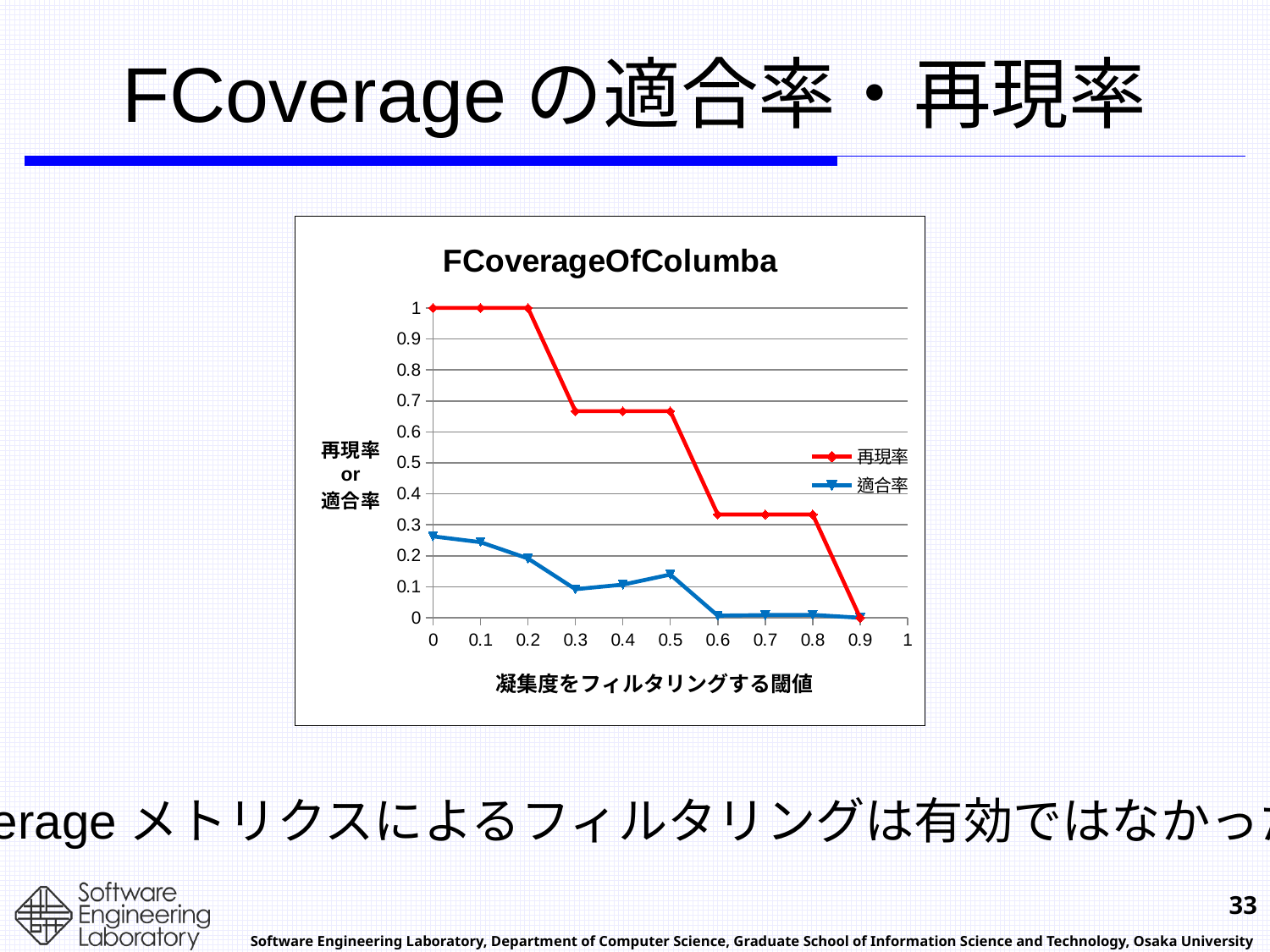
What is the value of 再現率 at threshold 0.9? 0 What kind of chart is shown on the slide? line chart Is the value of 再現率 at threshold 0.6 greater or less than 0.5? less At threshold 0.4, which series has the higher value, 再現率 or 適合率? 再現率 How many series does the legend list? 2 Is the value of 再現率 at threshold 0.3 greater or less than 0.5? greater Is the value of 適合率 at threshold 0.3 greater or less than 0.2? less Does the 再現率 series rise or fall as the threshold increases along the x axis? fall What is the label of the x axis? 凝集度をフィルタリングする閾値 What is the value of 再現率 at threshold 0? 1 How many data points does the 再現率 series have? 10 What is the title of the chart? FCoverageOfColumba